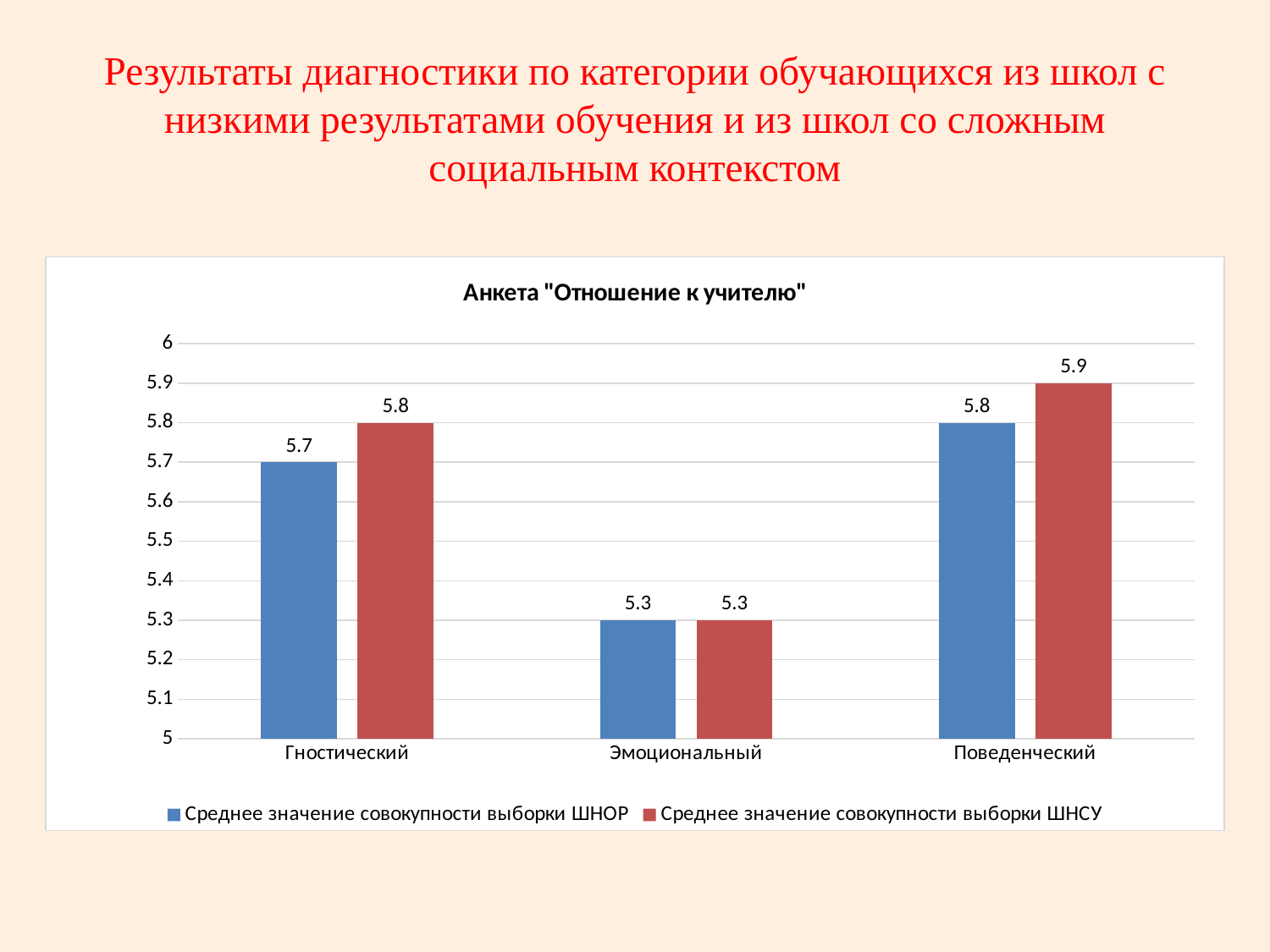
What is the difference between the ШНОР values for Поведенческий and Эмоциональный? 0.5 Which category has the highest value in the series Среднее значение совокупности выборки ШНСУ? Поведенческий What is the value for Поведенческий in the series Среднее значение совокупности выборки ШНСУ? 5.9 Which is larger for Поведенческий: the ШНОР value or the ШНСУ value? ШНСУ What is the title of the chart? Анкета "Отношение к учителю" What is the value for Гностический in the series Среднее значение совокупности выборки ШНОР? 5.7 What kind of chart is shown on the slide? Bar chart How many series does the legend list? 2 How many categories are shown on the x axis? 3 What is the value for Эмоциональный in the series Среднее значение совокупности выборки ШНОР? 5.3 Which category has the lowest value in the series Среднее значение совокупности выборки ШНОР? Эмоциональный What is the difference between the ШНСУ and ШНОР values for Гностический? 0.1